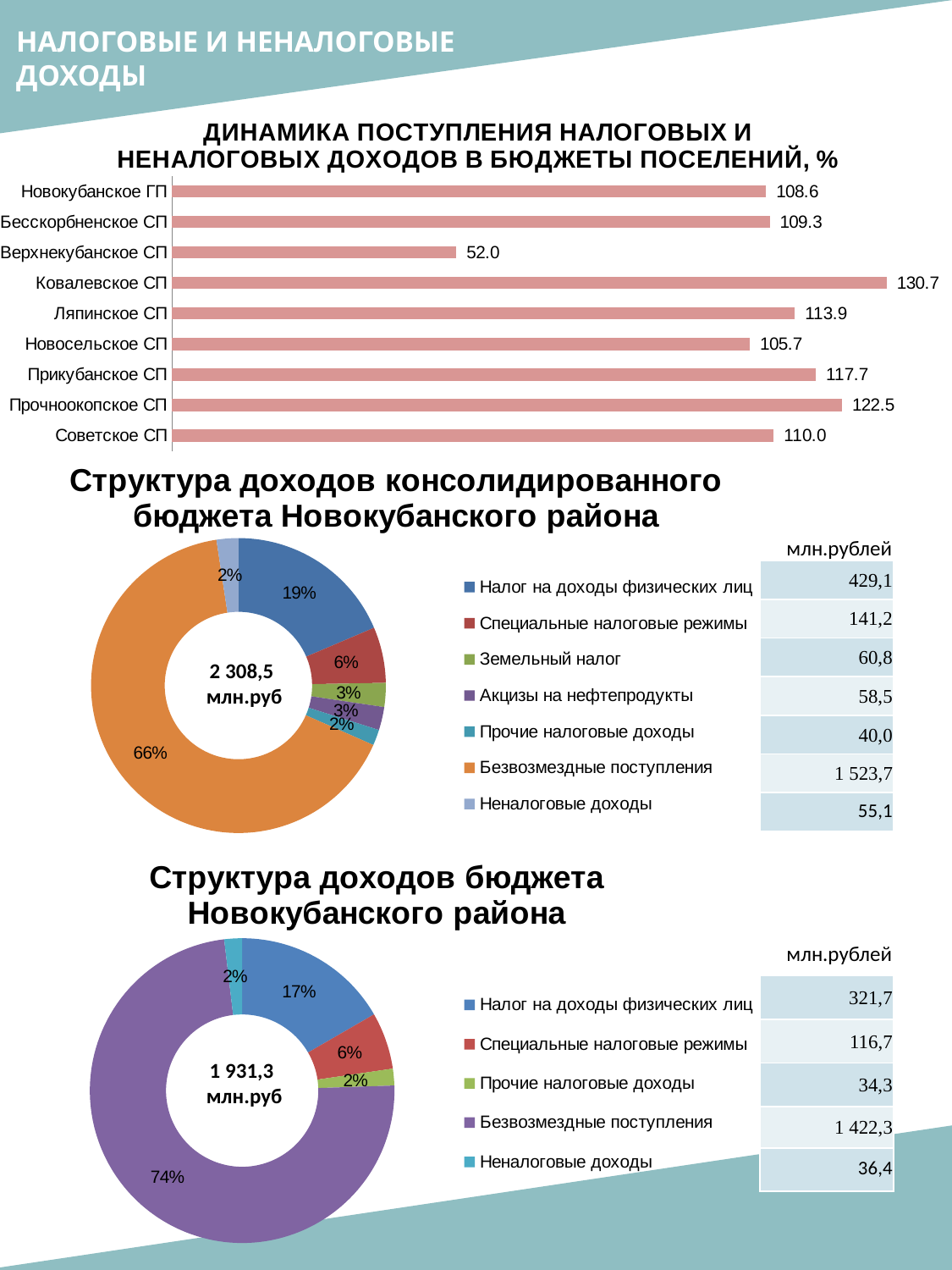
How many settlements are shown in the top bar chart? 9 In the doughnut chart 'Структура доходов консолидированного бюджета Новокубанского района', what is the value in млн.рублей for Налог на доходы физических лиц? 429,1 How many entries does the legend list for the doughnut chart 'Структура доходов консолидированного бюджета Новокубанского района'? 7 In the top bar chart, which settlement has the lowest value? Верхнекубанское СП What type of chart is the top chart on the slide? Bar chart In the doughnut chart 'Структура доходов бюджета Новокубанского района', what total is shown in the centre of the chart? 1 931,3 млн.руб In the doughnut chart 'Структура доходов консолидированного бюджета Новокубанского района', what share do Безвозмездные поступления make up? 66% In the doughnut chart 'Структура доходов бюджета Новокубанского района', what share do Безвозмездные поступления make up? 74% In the top bar chart, which settlement has the highest value? Ковалевское СП In the top bar chart, what is the difference between the values for Прочноокопское СП and Новосельское СП? 16.8 In the top bar chart 'Динамика поступления налоговых и неналоговых доходов в бюджеты поселений, %', what is the value for Ковалевское СП? 130.7 In the top bar chart, which is larger: the value for Ляпинское СП or the value for Прикубанское СП? Прикубанское СП